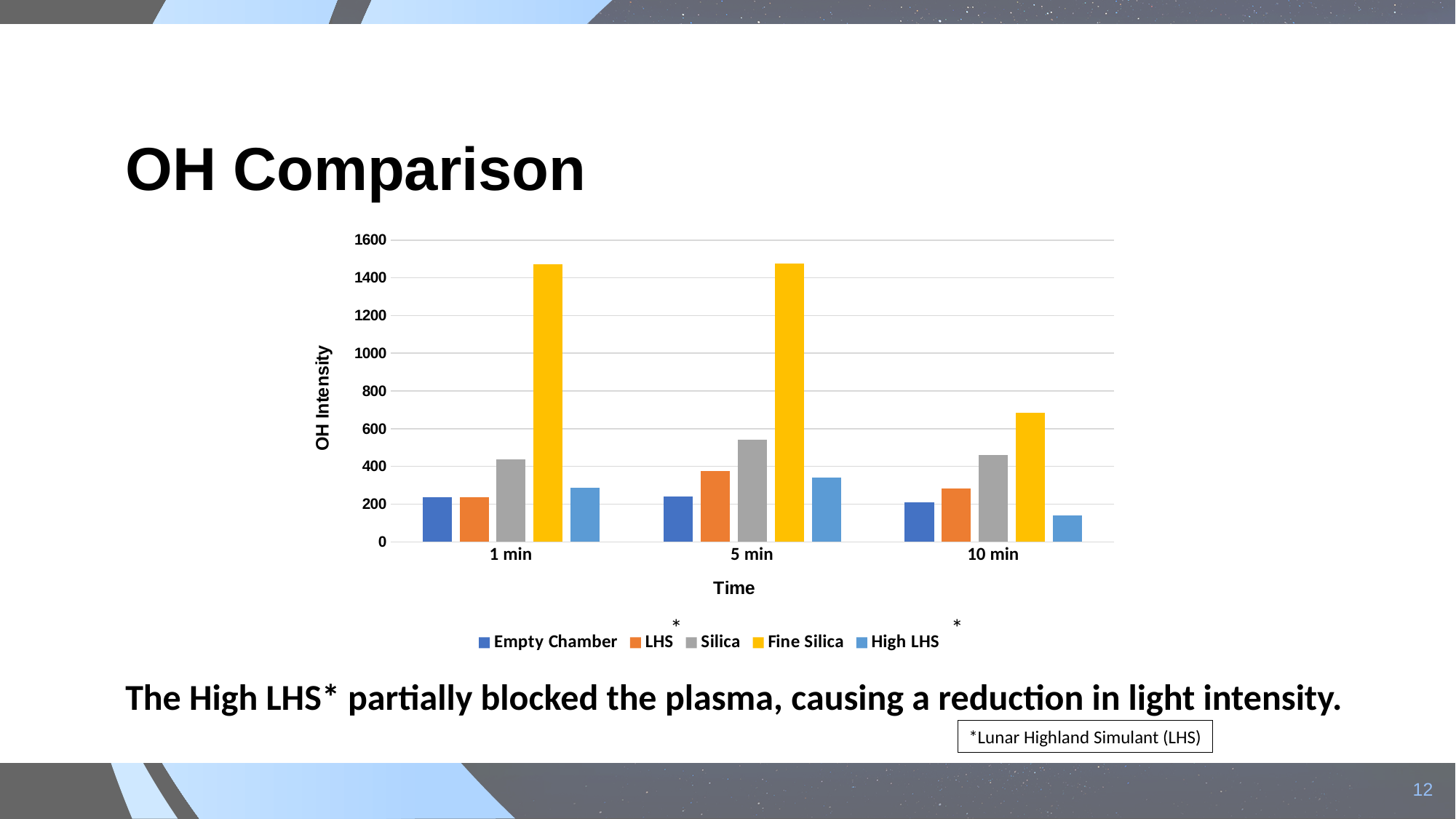
How many series does the legend list? 5 How many time categories are shown on the x axis? 3 Which series has the highest OH Intensity at 1 min? Fine Silica Does the Fine Silica value rise or fall from 5 min to 10 min? fall What is the title of the y axis? OH Intensity Is the value for Fine Silica at 1 min greater or less than 1400? greater At 5 min, which is larger: Silica or LHS? Silica Is the value for Fine Silica at 10 min greater or less than 800? less Is the value for High LHS at 10 min greater or less than 200? less Which is larger for Silica: the value at 5 min or the value at 10 min? 5 min What kind of chart is shown on the slide? bar chart Which series has the lowest OH Intensity at 10 min? High LHS